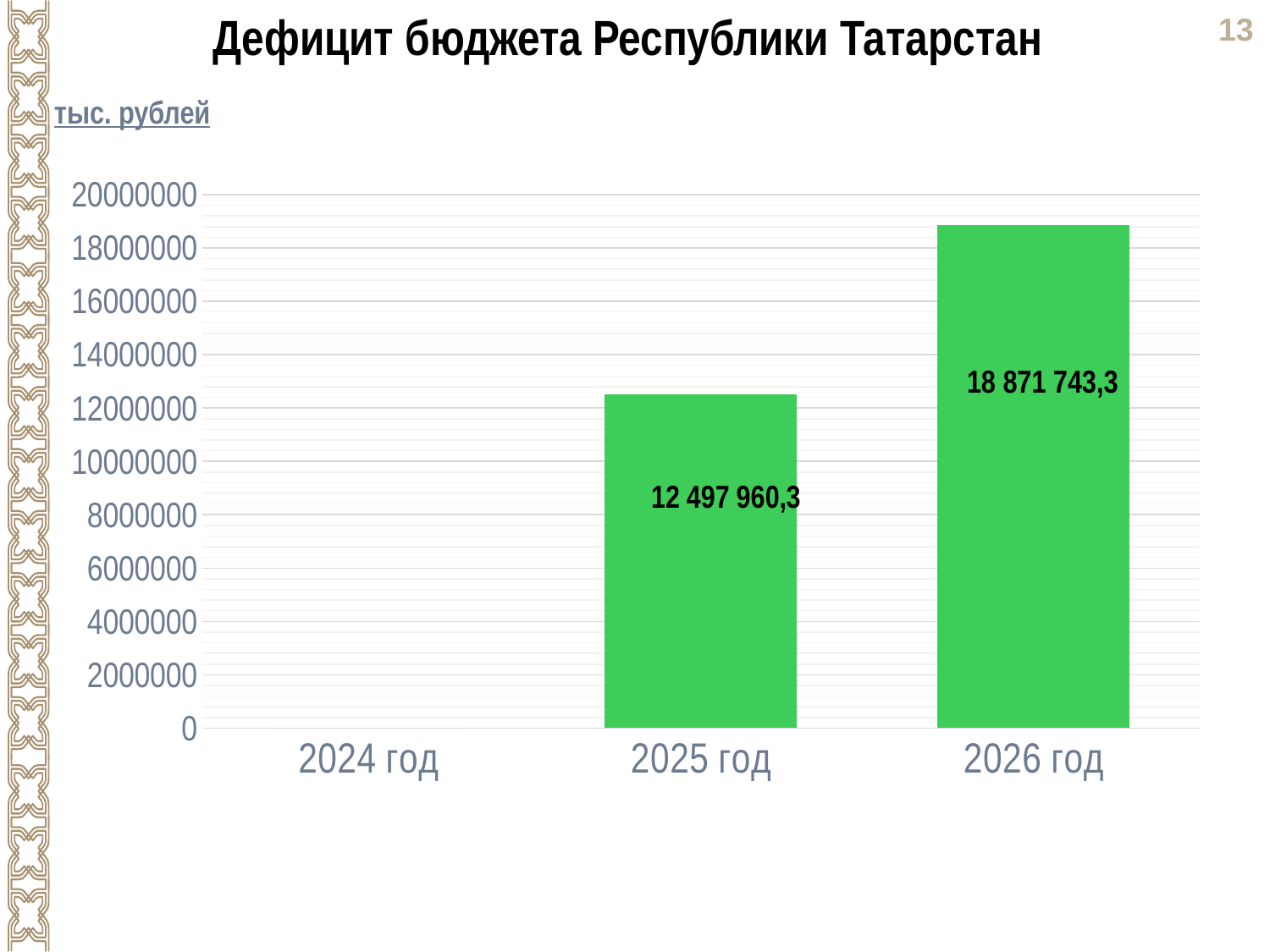
How many years are shown on the x axis? 3 What is the difference between the values for 2026 год and 2025 год? 6 373 783,0 What is the value for 2026 год? 18 871 743,3 What is the value for 2025 год? 12 497 960,3 Do the values rise or fall from 2025 год to 2026 год? rise Which year has the highest value? 2026 год What is the title of the chart? Дефицит бюджета Республики Татарстан In what units are the values on the chart given? тыс. рублей Is the value for 2026 год greater or less than 18000000? greater What kind of chart is shown on the slide? bar chart Which is larger, the value for 2025 год or the value for 2026 год? 2026 год Is the value for 2025 год greater or less than 14000000? less